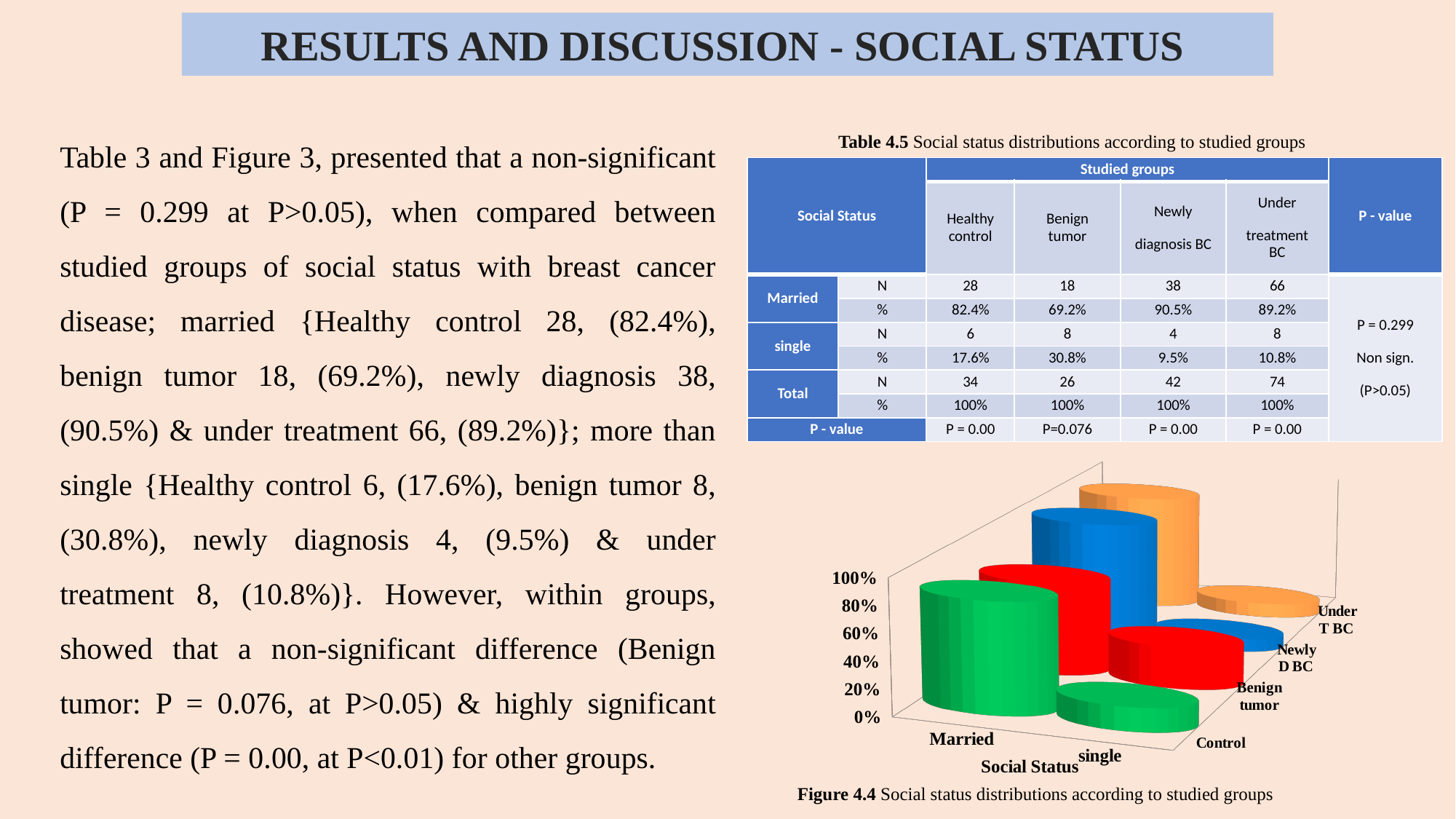
In Figure 4.4, which studied group has the highest value for single? Benign tumor In Figure 4.4, is the Married value for Benign tumor greater or less than 40%? greater In Figure 4.4, is the single value for Control greater or less than 40%? less What is the highest tick shown on the vertical axis of Figure 4.4? 100% In Figure 4.4, do the values rise or fall going from Married to single along the x axis? fall How many social status categories are shown on the x axis of Figure 4.4? 2 In Figure 4.4, is the single value for Benign tumor greater or less than 60%? less What kind of chart is Figure 4.4? bar chart In Figure 4.4, which is larger for Control: the Married value or the single value? Married What is the title of the horizontal axis in Figure 4.4? Social Status How many studied groups are plotted as series in Figure 4.4? 4